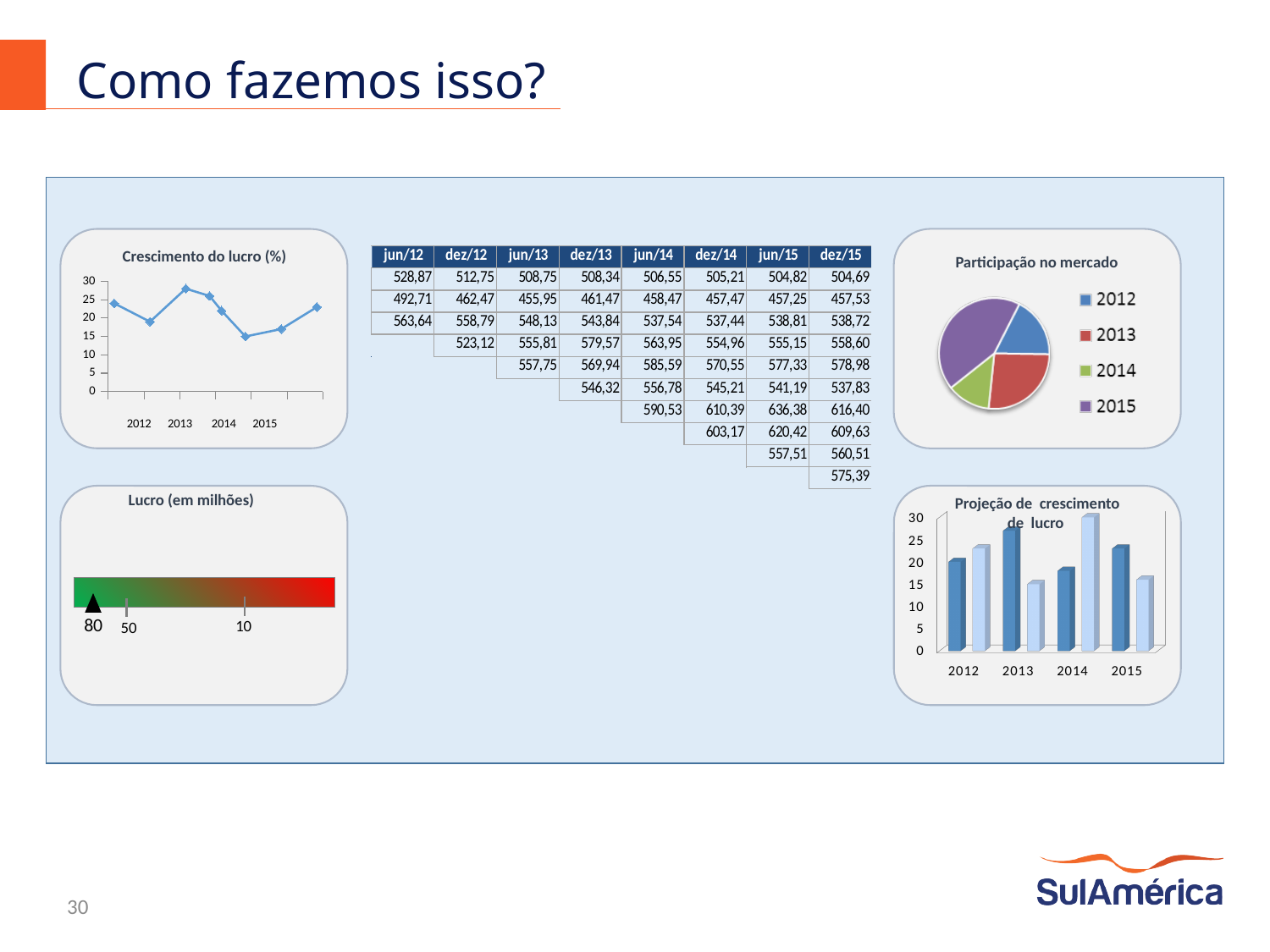
In the "Crescimento do lucro (%)" chart, is the first plotted point greater or less than 20? greater In the "Participação no mercado" chart, which year has the smallest slice? 2014 What kind of chart is "Participação no mercado"? pie chart What kind of chart is "Crescimento do lucro (%)"? line chart In the "Projeção de crescimento de lucro" chart, is the light blue bar for 2013 greater or less than 20? less What kind of chart is "Projeção de crescimento de lucro"? bar chart In the "Projeção de crescimento de lucro" chart, for 2014, which bar is taller: the dark blue or the light blue? light blue In the "Participação no mercado" chart, how many entries does the legend list? 4 In the "Projeção de crescimento de lucro" chart, is the light blue bar for 2014 greater or less than 25? greater In the "Participação no mercado" chart, which year has the largest slice? 2015 In the "Projeção de crescimento de lucro" chart, how many categories are shown on the x axis? 4 In the "Crescimento do lucro (%)" chart, how many data points are plotted on the line? 8